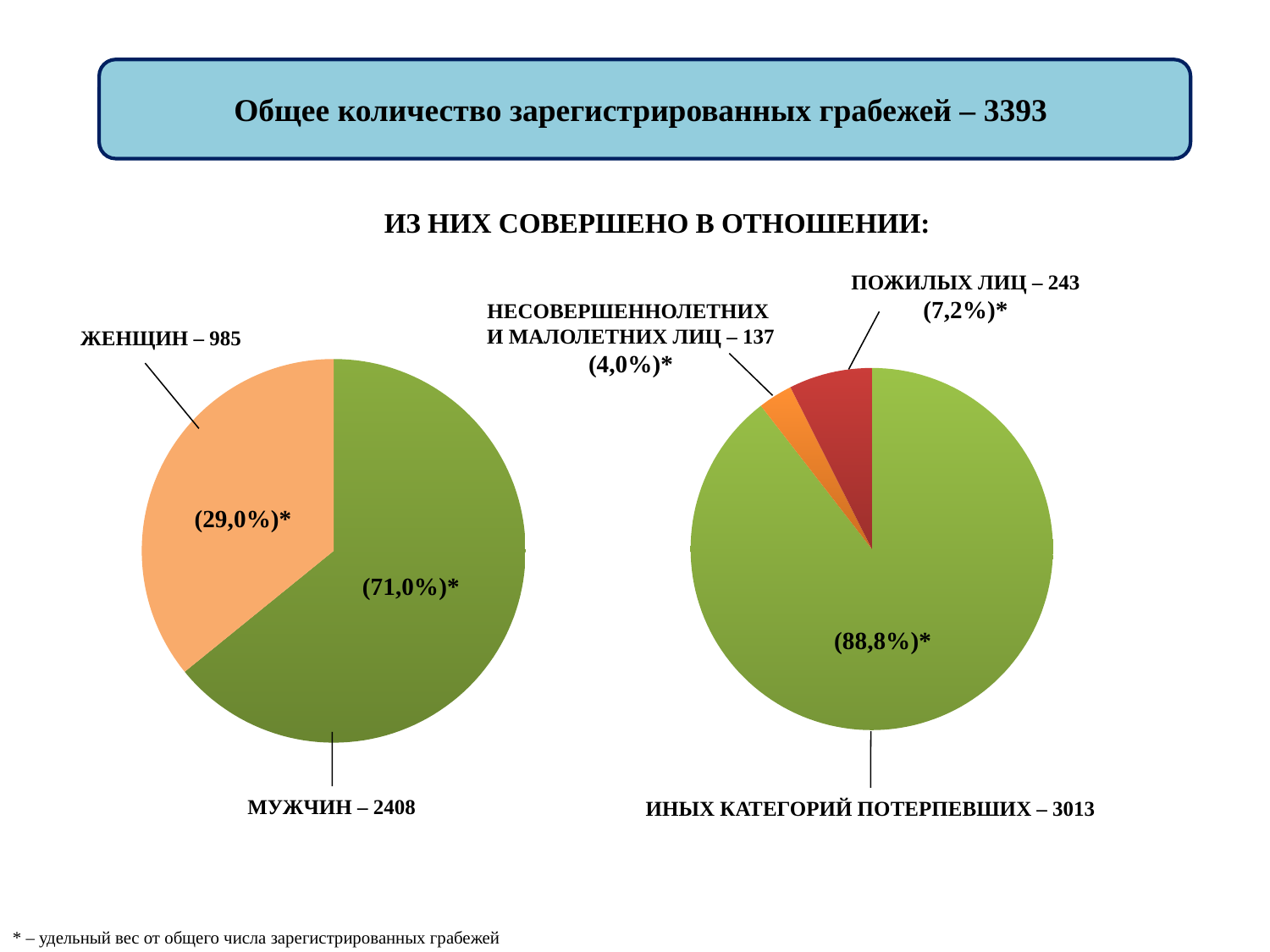
On the left pie chart, what is the value for ЖЕНЩИН (women)? 985 On the right pie chart, which is larger: the value for ПОЖИЛЫХ ЛИЦ or for НЕСОВЕРШЕННОЛЕТНИХ И МАЛОЛЕТНИХ ЛИЦ? ПОЖИЛЫХ ЛИЦ On the right pie chart, which category has the smallest value? НЕСОВЕРШЕННОЛЕТНИХ И МАЛОЛЕТНИХ ЛИЦ On the left pie chart, what is the value for МУЖЧИН (men)? 2408 On the left pie chart, what share of the pie does the МУЖЧИН (men) slice represent? 71,0% On the left pie chart, what is the difference between the values for МУЖЧИН and ЖЕНЩИН? 1423 On the right pie chart, what share of the pie does ИНЫХ КАТЕГОРИЙ ПОТЕРПЕВШИХ (other categories of victims) represent? 88,8% What type of chart is shown on the left of the slide? Pie chart On the right pie chart, what is the value for НЕСОВЕРШЕННОЛЕТНИХ И МАЛОЛЕТНИХ ЛИЦ (minors)? 137 How many slices does the right pie chart have? 3 On the right pie chart, which category has the largest value? ИНЫХ КАТЕГОРИЙ ПОТЕРПЕВШИХ On the right pie chart, what is the value for ПОЖИЛЫХ ЛИЦ (elderly persons)? 243